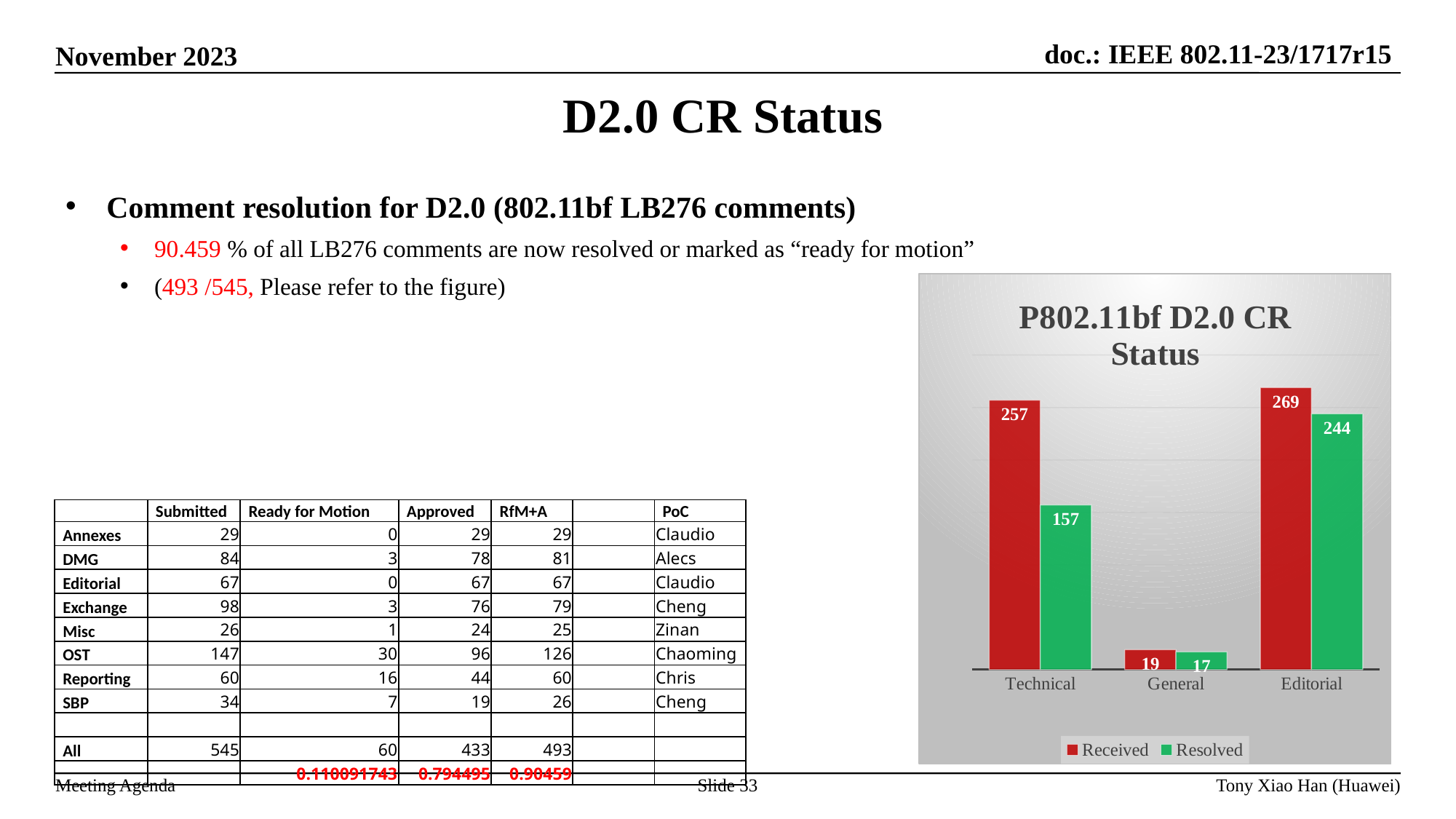
What is the Resolved value for Editorial? 244 How many series does the legend list? 2 How many categories are shown on the x axis? 3 What kind of chart is shown? bar chart What is the difference between Received and Resolved for Editorial? 25 What is the title of the chart? P802.11bf D2.0 CR Status What is the Resolved value for General? 17 What is the Received value for Technical? 257 What is the difference between Received and Resolved for Technical? 100 Which category has the highest Received value? Editorial Which category has the lowest Resolved value? General Which is larger, the Resolved value for Technical or the Resolved value for Editorial? Editorial